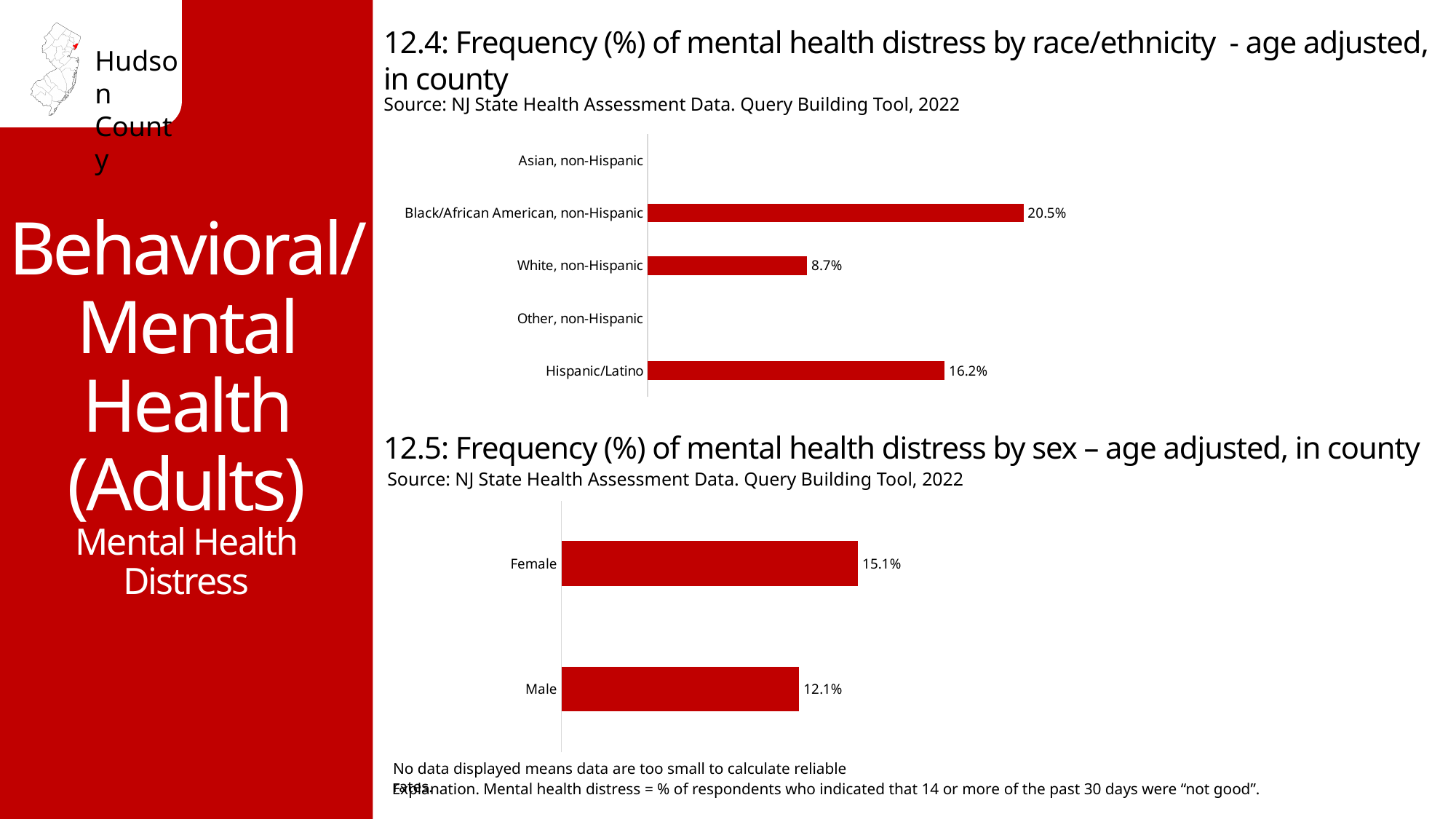
In chart 12.5 (mental health distress by sex), what is the value for Male? 12.1% In chart 12.4 (mental health distress by race/ethnicity), what is the difference between the Black/African American, non-Hispanic and White, non-Hispanic values? 11.8% In chart 12.4 (mental health distress by race/ethnicity), what is the value for Black/African American, non-Hispanic? 20.5% In chart 12.5 (mental health distress by sex), what is the difference between the Female and Male values? 3.0% In chart 12.4 (mental health distress by race/ethnicity), how many race/ethnicity categories are listed on the axis? 5 In chart 12.4 (mental health distress by race/ethnicity), which is larger: the value for Hispanic/Latino or for White, non-Hispanic? Hispanic/Latino In chart 12.4 (mental health distress by race/ethnicity), what is the value for White, non-Hispanic? 8.7% What kind of chart is chart 12.5 (mental health distress by sex)? Bar chart In chart 12.4 (mental health distress by race/ethnicity), which race/ethnicity group has the highest value? Black/African American, non-Hispanic In chart 12.5 (mental health distress by sex), what is the value for Female? 15.1% In chart 12.4 (mental health distress by race/ethnicity), what is the value for Hispanic/Latino? 16.2% In chart 12.4 (mental health distress by race/ethnicity), which categories have no bar displayed? Asian, non-Hispanic and Other, non-Hispanic